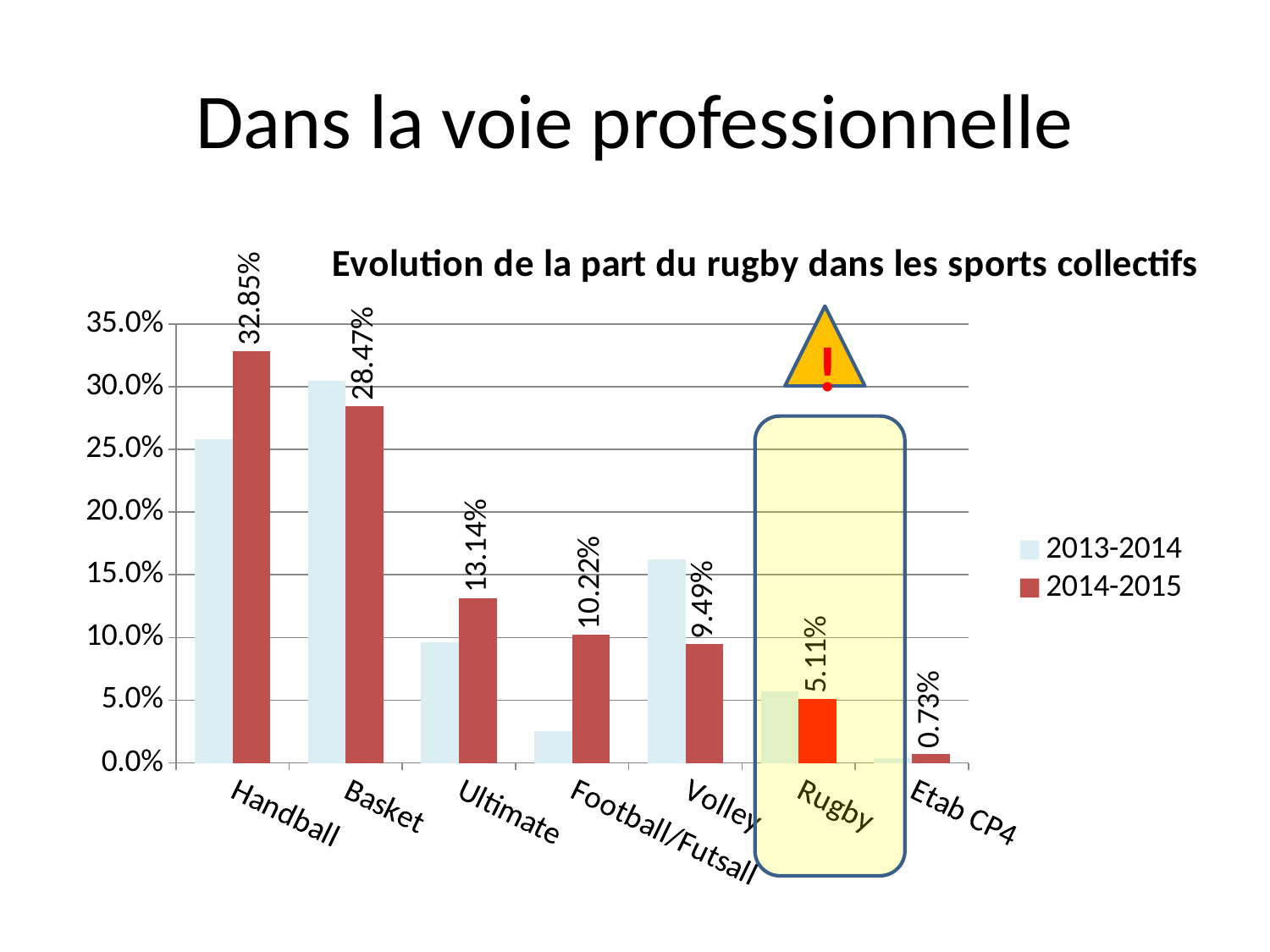
What is the 2014-2015 value for Handball? 32.85% What is the 2014-2015 value for Etab CP4? 0.73% Which has the larger 2014-2015 value, Ultimate or Football/Futsall? Ultimate How many series does the legend list? 2 For Volley, which series has the larger value, 2013-2014 or 2014-2015? 2013-2014 What is the 2014-2015 value for Rugby? 5.11% Which category has the lowest 2014-2015 value? Etab CP4 How many categories are shown on the x axis? 7 Is the 2013-2014 value for Football/Futsall greater or less than 5.0%? less Which category has the highest 2014-2015 value? Handball What kind of chart is shown on the slide? bar chart What is the difference between the 2014-2015 values for Handball and Basket? 4.38%